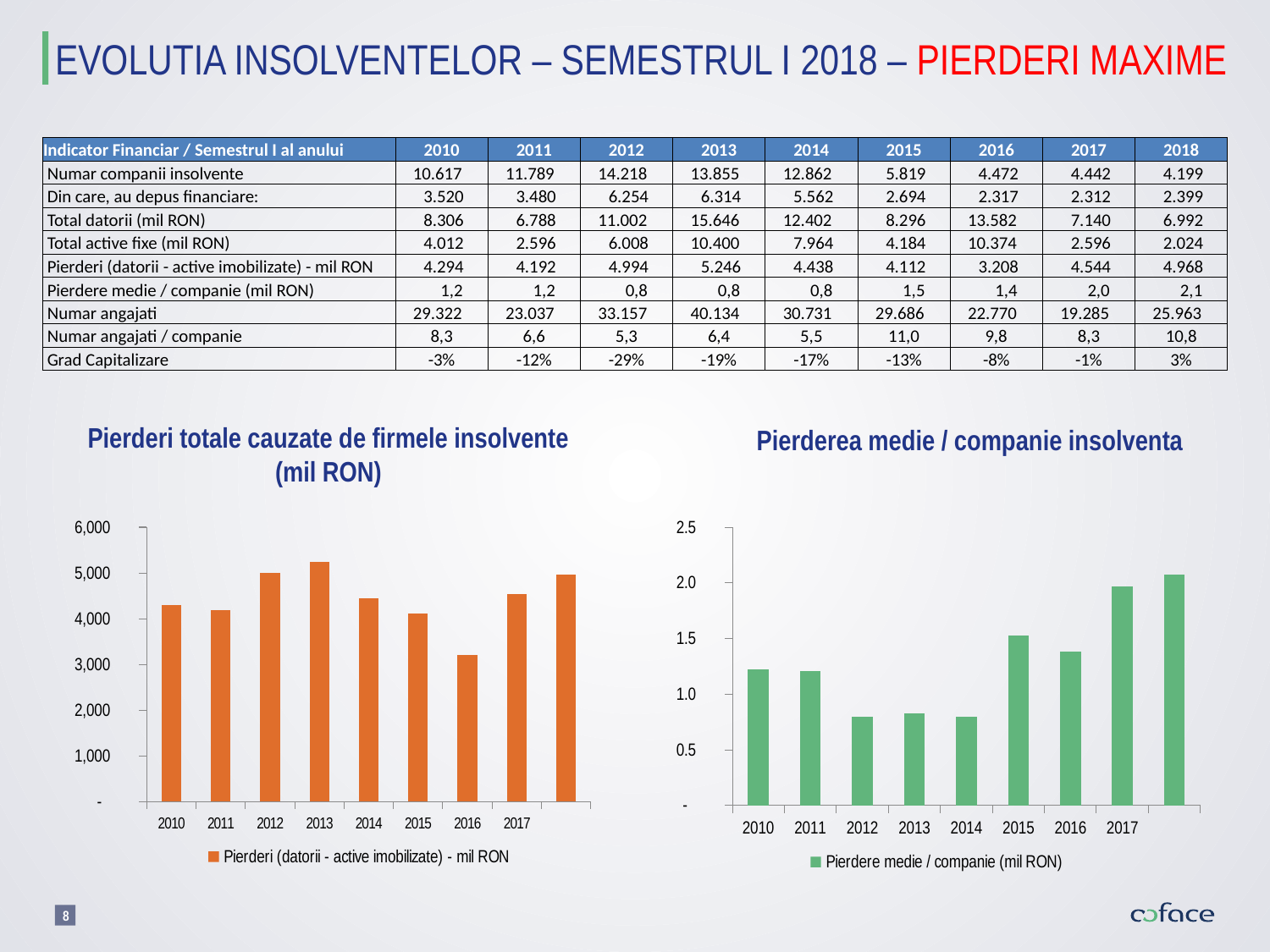
How many series does the legend of the chart 'Pierderi totale cauzate de firmele insolvente (mil RON)' list? 1 In the chart 'Pierderi totale cauzate de firmele insolvente (mil RON)', which year has the highest bar? 2013 In the chart 'Pierderi totale cauzate de firmele insolvente (mil RON)', which year has the lowest bar? 2016 In the chart 'Pierderea medie / companie insolventa', is the value for 2012 greater or less than 1.0? less What colour are the bars in the chart 'Pierderea medie / companie insolventa'? green What kind of chart is 'Pierderi totale cauzate de firmele insolvente (mil RON)'? bar chart What is the legend entry of the chart 'Pierderea medie / companie insolventa'? Pierdere medie / companie (mil RON) In the chart 'Pierderi totale cauzate de firmele insolvente (mil RON)', which is larger, the value for 2012 or the value for 2011? 2012 In the chart 'Pierderi totale cauzate de firmele insolvente (mil RON)', is the value for 2013 greater or less than 5,000? greater In the chart 'Pierderea medie / companie insolventa', is the value for 2017 greater or less than 1.5? greater In the chart 'Pierderea medie / companie insolventa', which is larger, the value for 2017 or the value for 2016? 2017